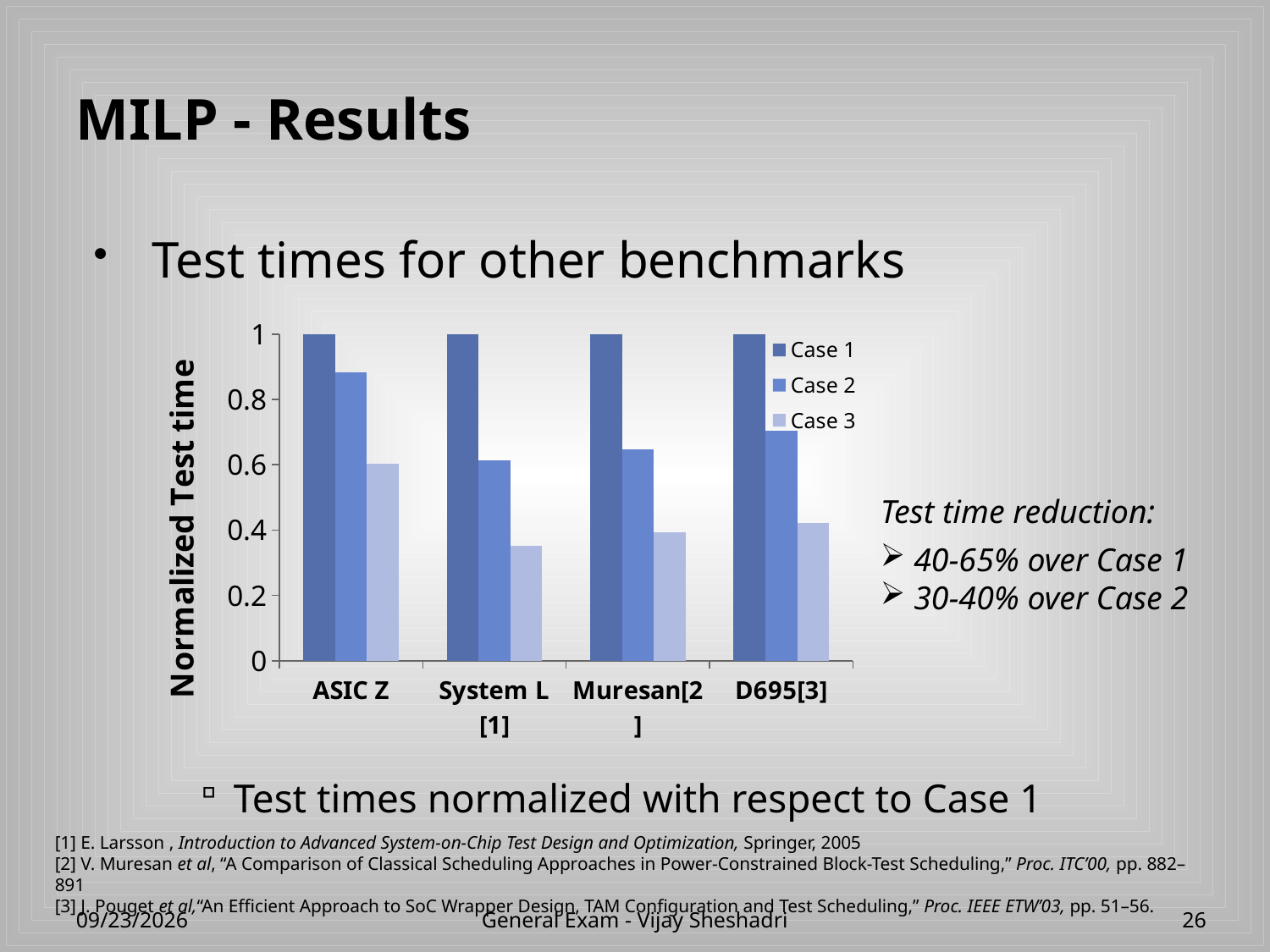
Which benchmark has the lowest Case 3 value? System L [1] How many benchmark categories are shown on the x axis? 4 How many series does the legend list? 3 Which benchmark has the highest Case 2 value? ASIC Z What kind of chart is shown on the slide? bar chart What is the normalized test time for Case 1 for D695[3]? 1 What is the normalized test time for Case 1 for ASIC Z? 1 Is the Case 2 value for D695[3] greater or less than 0.6? greater Is the Case 2 value for ASIC Z greater or less than 0.8? greater Is the Case 3 value for System L [1] greater or less than 0.4? less Which is larger, the Case 3 value for ASIC Z or the Case 3 value for System L [1]? ASIC Z